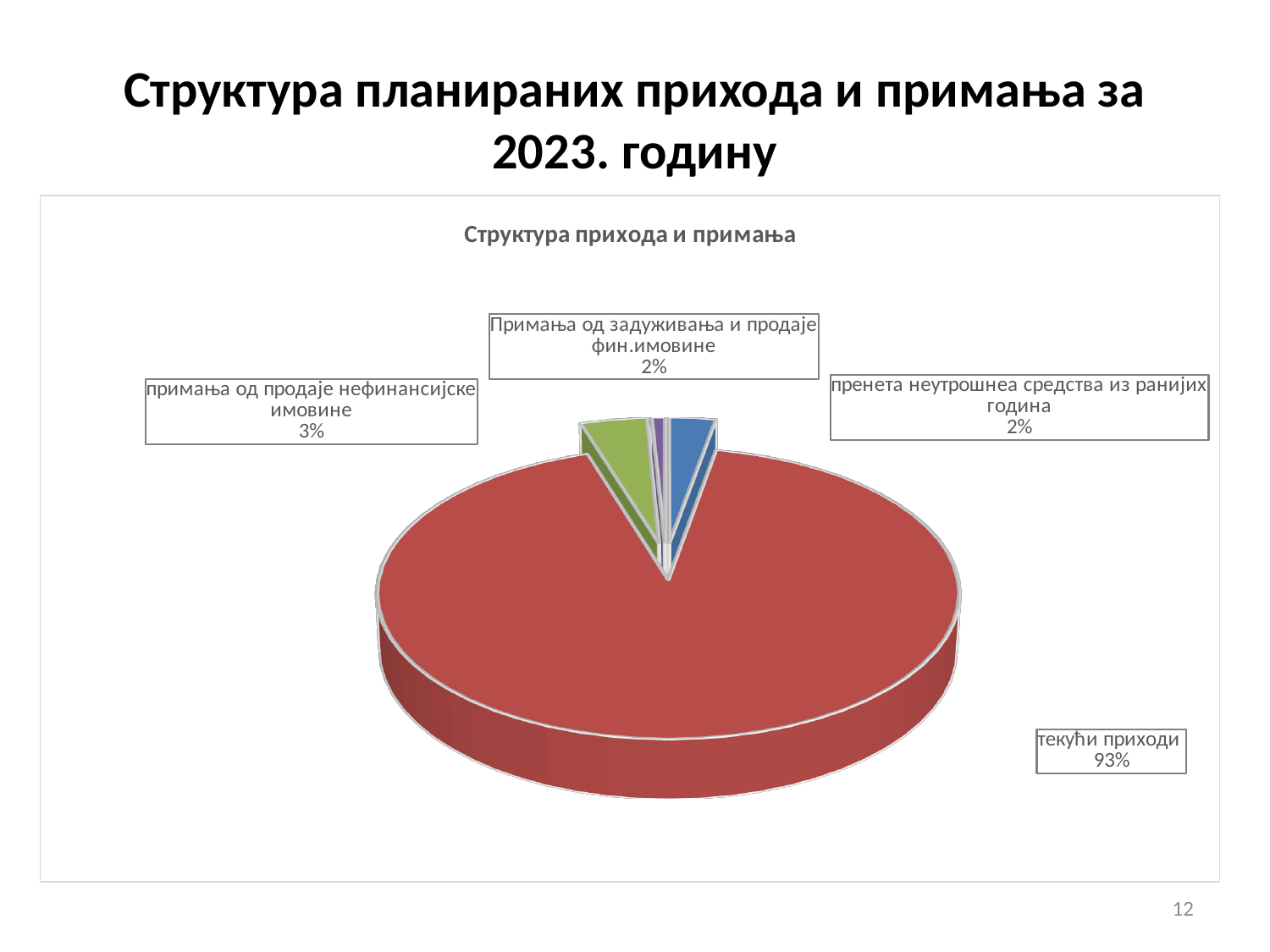
What share of the pie is пренета неутрошнеа средства из ранијих година? 2% Is the share for текући приходи greater or less than 50%? greater Which is larger: примања од продаје нефинансијске имовине or пренета неутрошнеа средства из ранијих година? примања од продаје нефинансијске имовине What share of the pie is текући приходи? 93% What kind of chart is shown on the slide? pie chart What is the difference in percentage points between текући приходи and примања од продаје нефинансијске имовине? 90 Which category has the largest share of the pie? текући приходи What share of the pie is примања од продаје нефинансијске имовине? 3% What is the title of the chart? Структура прихода и примања What colour is the slice for текући приходи? red How many slices does the pie chart have? 4